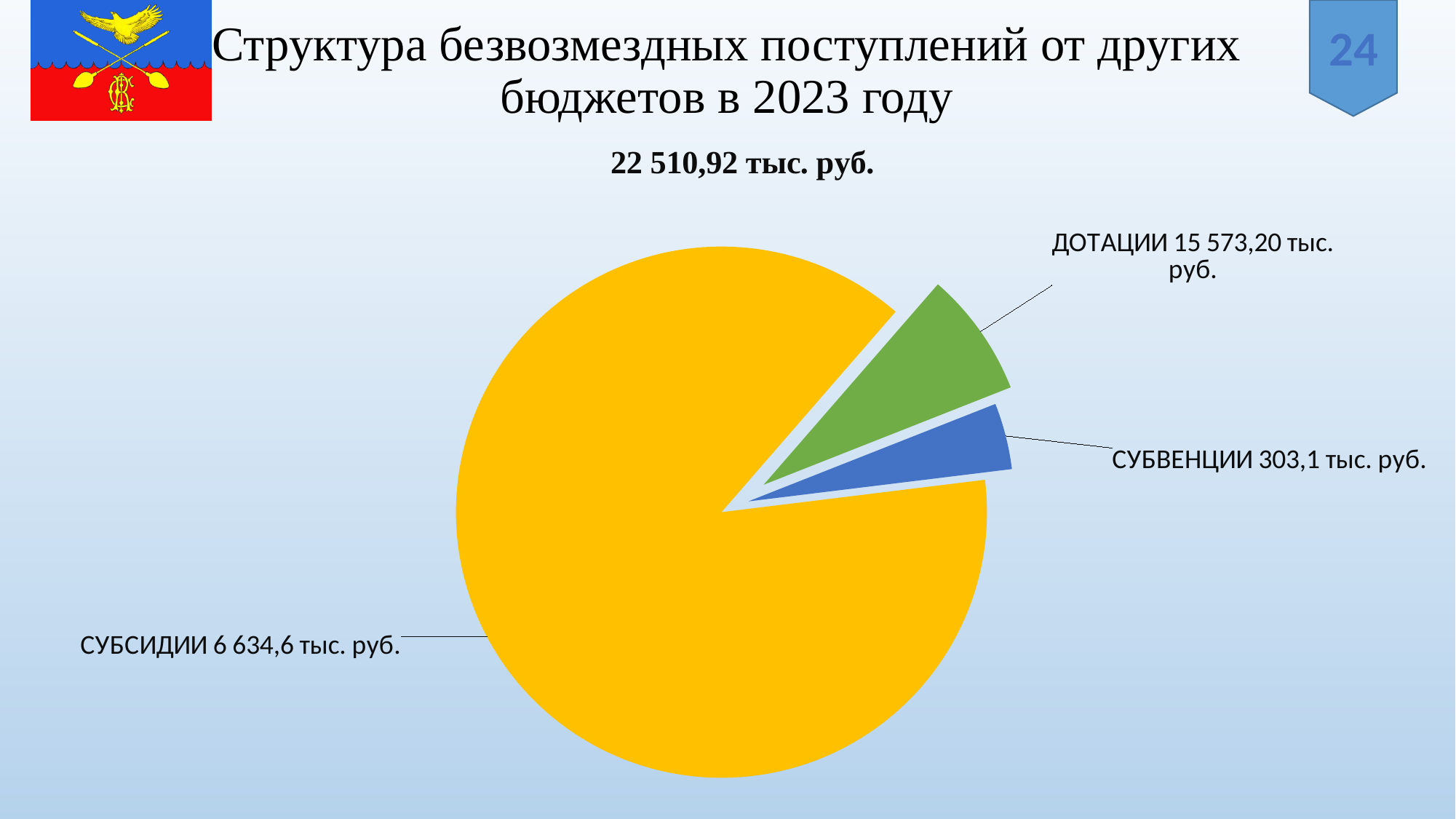
What is the difference between the printed values for СУБСИДИИ and СУБВЕНЦИИ? 6 331,5 тыс. руб. Which category has the smallest printed value? СУБВЕНЦИИ What total amount is printed above the pie chart? 22 510,92 тыс. руб. What is the value shown for СУБСИДИИ? 6 634,6 тыс. руб. Which has the larger printed value, СУБСИДИИ or СУБВЕНЦИИ? СУБСИДИИ What is the value shown for ДОТАЦИИ? 15 573,20 тыс. руб. Which category has the largest printed value? ДОТАЦИИ How many slices does the pie chart have? 3 What is the difference between the printed values for ДОТАЦИИ and СУБСИДИИ? 8 938,6 тыс. руб. What colour is the slice labelled СУБВЕНЦИИ? Blue What is the value shown for СУБВЕНЦИИ? 303,1 тыс. руб. What kind of chart is shown on the slide? Pie chart